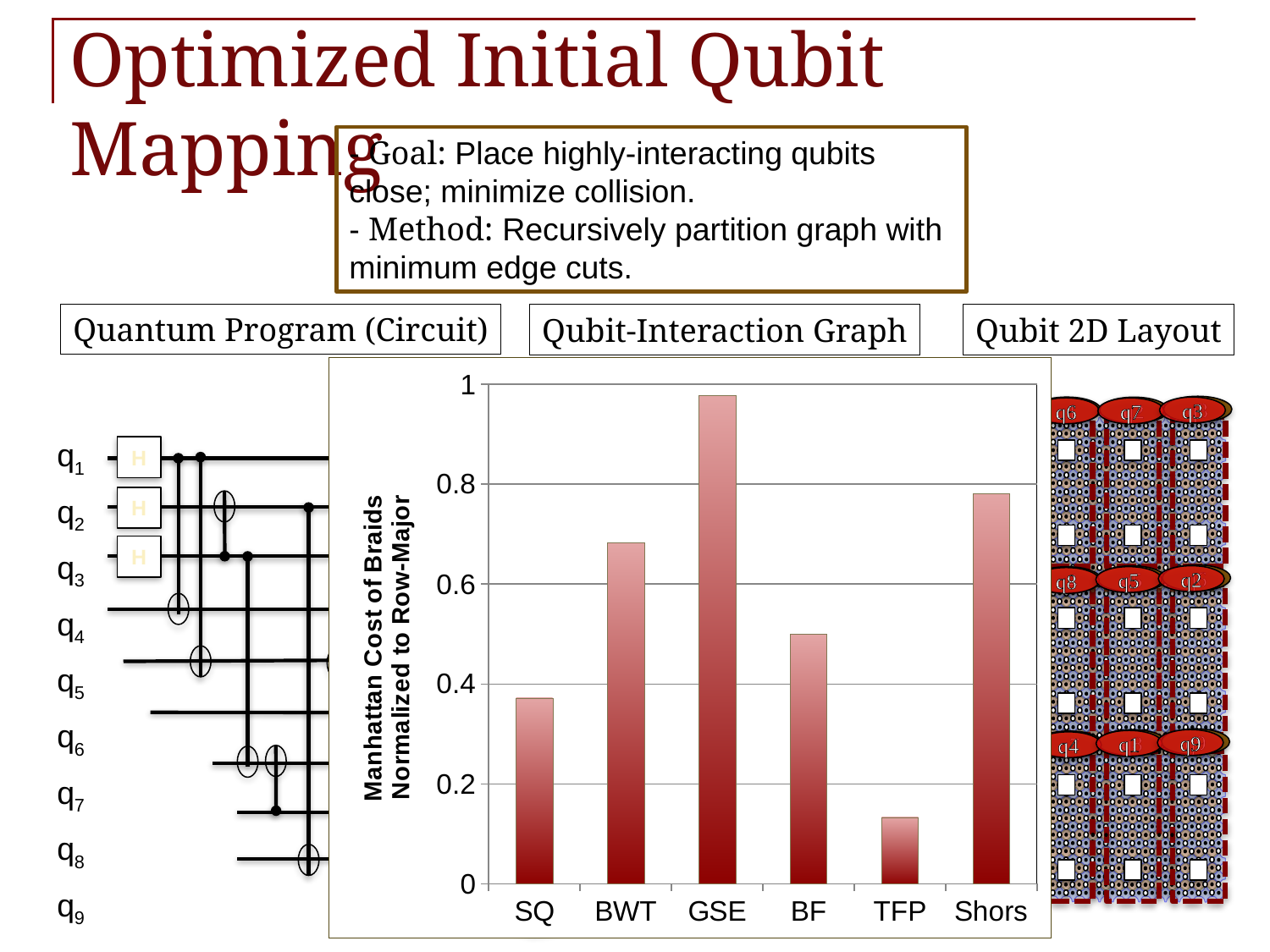
Which is larger, the value for SQ or the value for Shors? Shors How many categories are plotted on the x axis of the chart? 6 Which category has the lowest Manhattan cost of braids normalized to row-major? TFP Which is larger, the value for BWT or the value for BF? BWT Is the value for BWT greater or less than 0.6? greater What is the label of the y axis of the chart? Manhattan Cost of Braids Normalized to Row-Major Which category has the highest Manhattan cost of braids normalized to row-major? GSE Is the value for TFP greater or less than 0.2? less What kind of chart is shown on the slide? bar chart Is the value for GSE greater or less than 0.8? greater